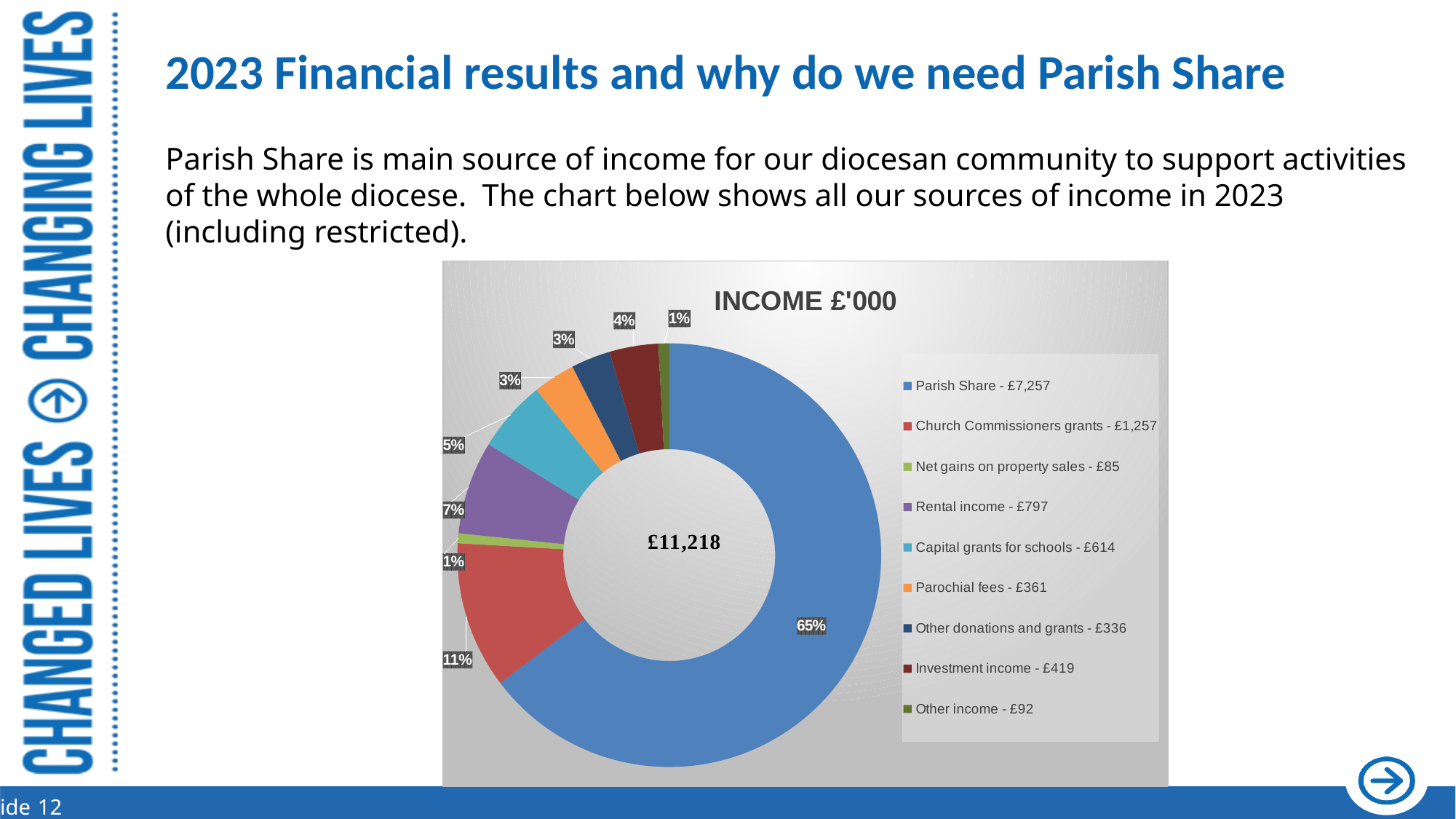
What type of chart is shown on the slide? Pie (doughnut) chart Which income source is the smallest? Net gains on property sales What is the title of the chart? INCOME £'000 Which income source is the largest? Parish Share What is the difference between Rental income and Capital grants for schools? £183 What total income figure is shown in the centre of the chart? £11,218 How many income categories does the legend list? 9 What percentage share of income does Rental income represent? 7% What is the value for Capital grants for schools? £614 What percentage share of income does Parish Share represent? 65% What is the value for Parish Share shown in the legend? £7,257 What is the value for Church Commissioners grants shown in the legend? £1,257